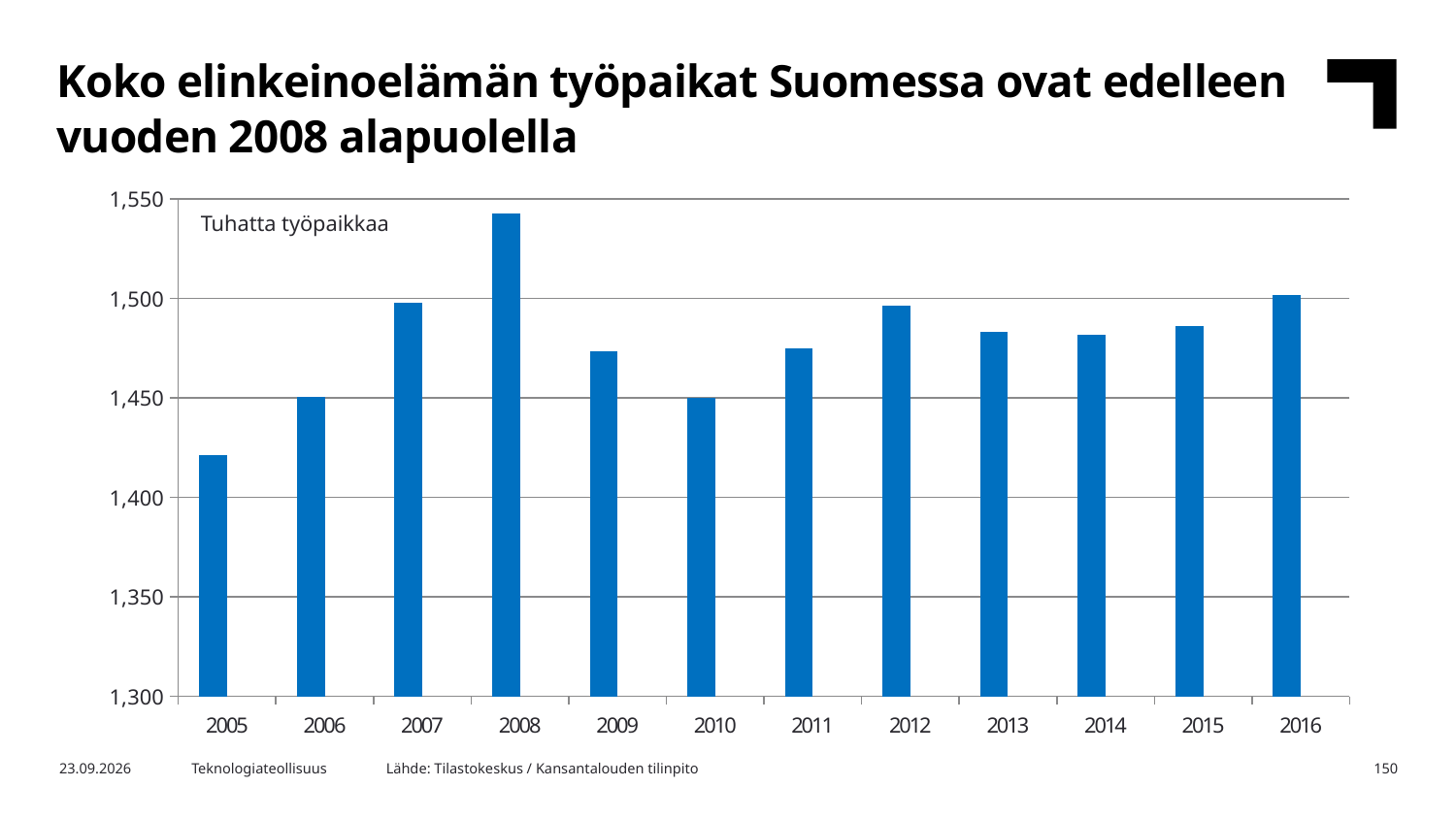
How many years are shown on the x axis? 12 Which is larger, the value for 2005 or the value for 2010? 2010 Is the value for 2005 greater or less than 1,400? greater Is the value for 2009 greater or less than 1,450? greater Which year has the lowest number of jobs? 2005 Is the value for 2013 greater or less than 1,500? less Do the values rise or fall from 2005 to 2008? rise What kind of chart is shown on the slide? bar chart Which year has the highest number of jobs? 2008 Which is larger, the value for 2008 or the value for 2016? 2008 What unit label is shown inside the chart area? Tuhatta työpaikkaa